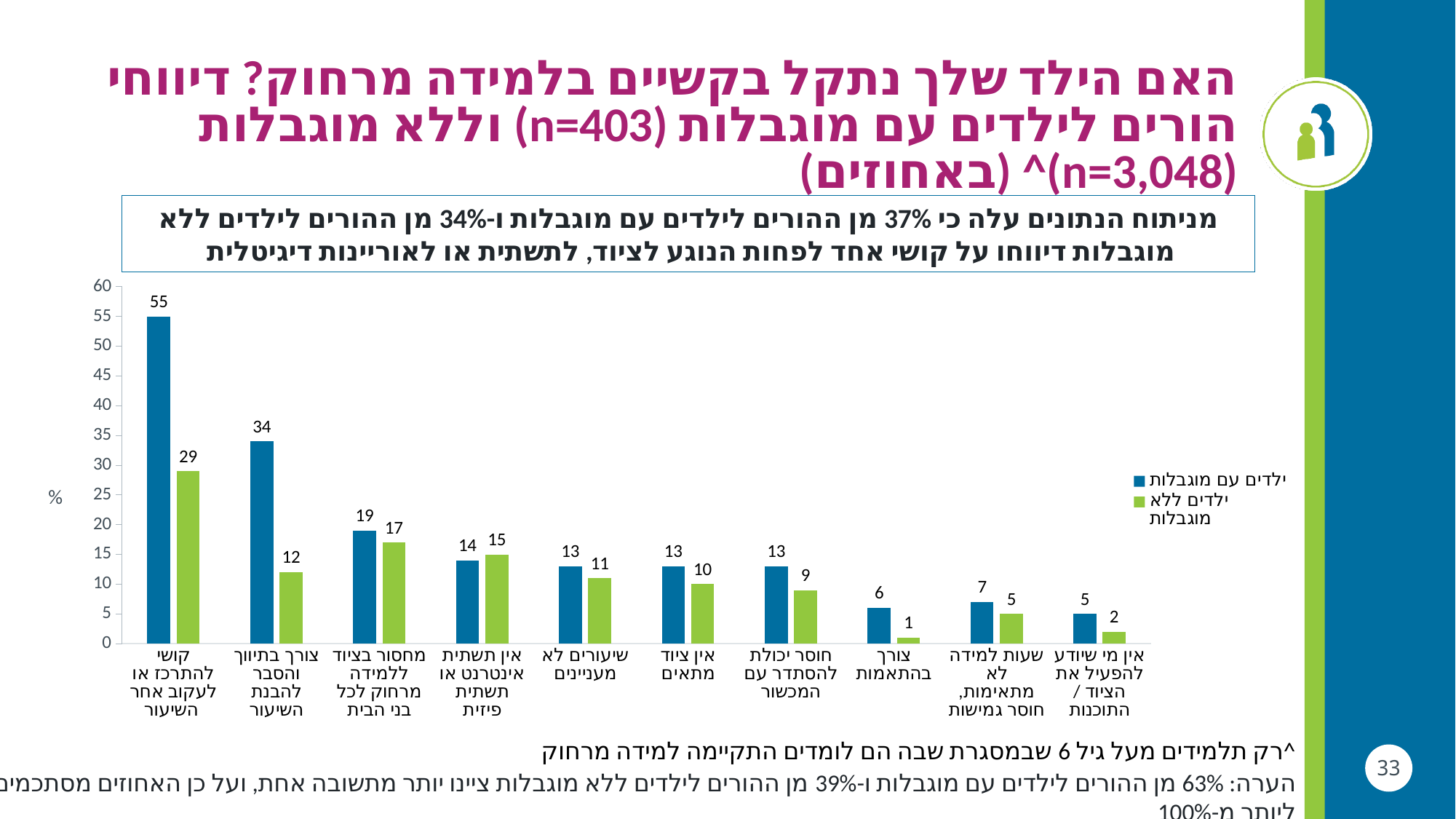
What kind of chart is shown on the slide? bar chart What is the value for 'ילדים ללא מוגבלות' in the category 'צורך בתיווך והסבר להבנת השיעור'? 12 What is the value for 'ילדים עם מוגבלות' in the category 'קושי להתרכז או לעקוב אחר השיעור'? 55 How many series does the chart's legend list? 2 Which category has the highest value for 'ילדים עם מוגבלות'? קושי להתרכז או לעקוב אחר השיעור Which category has the lowest value for 'ילדים ללא מוגבלות'? צורך בהתאמות What is the difference between the 'ילדים עם מוגבלות' and 'ילדים ללא מוגבלות' values in the category 'קושי להתרכז או לעקוב אחר השיעור'? 26 What colour are the bars for the series 'ילדים ללא מוגבלות'? green Is the value for 'ילדים עם מוגבלות' in the category 'צורך בתיווך והסבר להבנת השיעור' greater or less than 30? greater What is the value for 'ילדים ללא מוגבלות' in the category 'אין תשתית אינטרנט או תשתית פיזית'? 15 How many categories are shown on the x axis of the chart? 10 In the category 'אין תשתית אינטרנט או תשתית פיזית', which series has the larger value? ילדים ללא מוגבלות